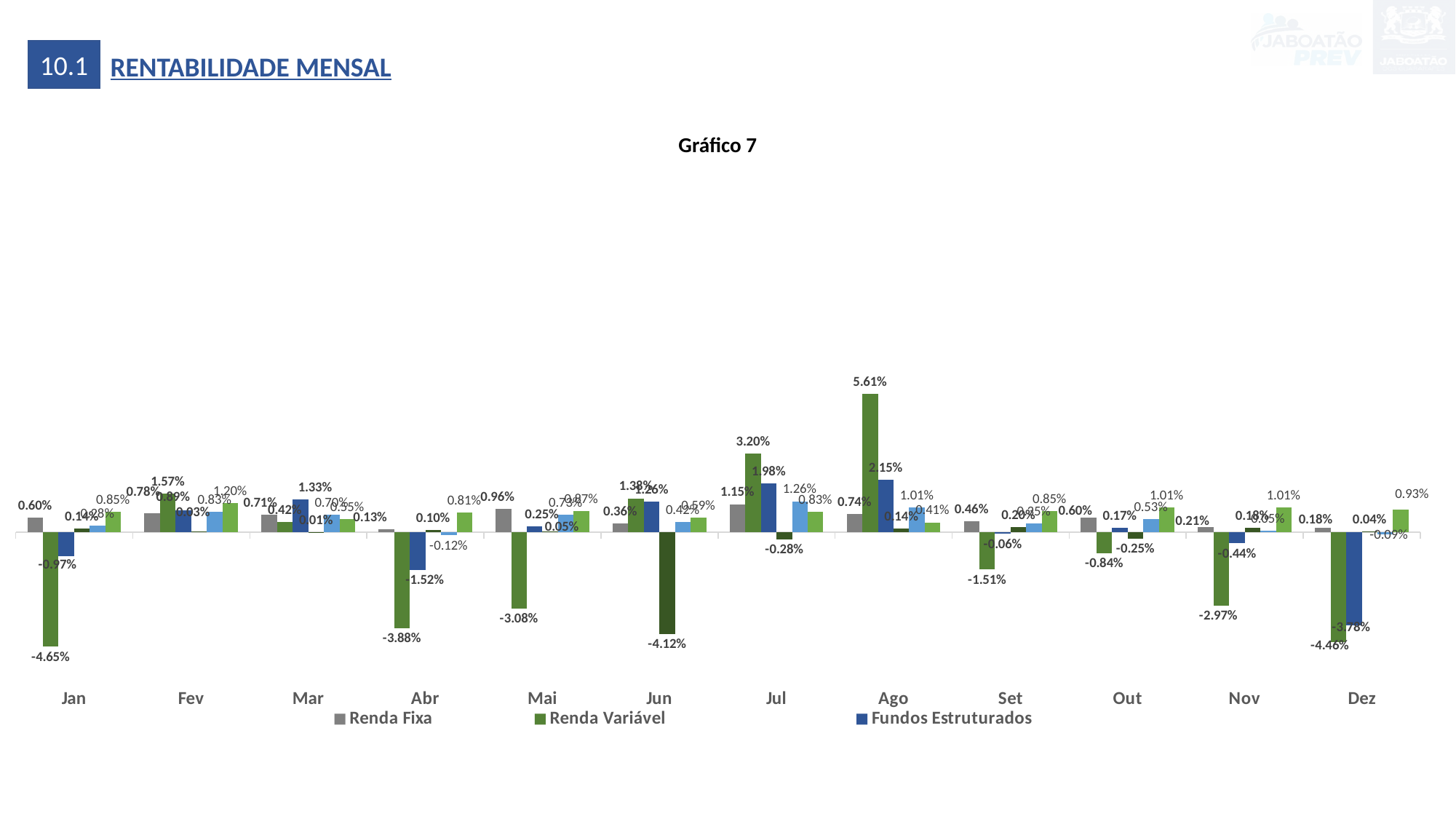
In which month is Renda Variável highest? Ago What is the title of the chart on the slide? Gráfico 7 What is the Renda Variável value for Ago? 5.61% How many series does the legend of Gráfico 7 list? 3 Which is larger in Jul, Renda Variável or Fundos Estruturados? Renda Variável What is the Renda Variável value for Jan? -4.65% What is the Renda Fixa value for Jul? 1.15% What is the Fundos Estruturados value for Dez? -3.78% In which month is Renda Variável lowest? Jan What is the difference between the Renda Variável values for Ago and Jul? 2.41 percentage points What type of chart is Gráfico 7? bar chart How many months are shown on the x axis of Gráfico 7? 12